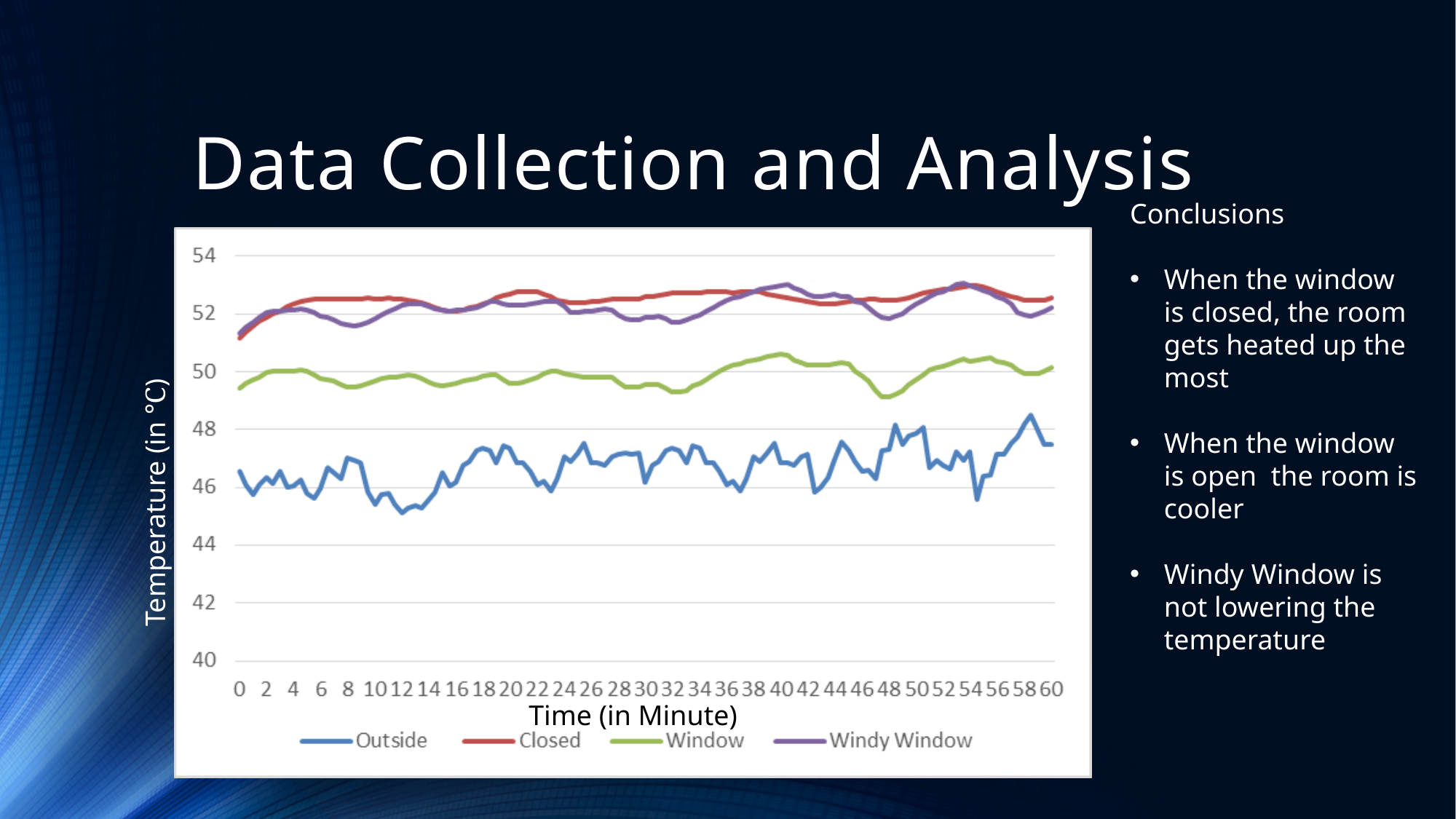
How many series does the chart legend list? 4 What is the title of the vertical axis of the chart? Temperature (in °C) Is the value for the Windy Window series at minute 40 greater or less than 52? greater What kind of chart is shown on the slide? Line chart What are the four series named in the chart legend? Outside, Closed, Window, Windy Window Is the value for the Outside series at minute 12 greater or less than 46? less Is the value for the Closed series at minute 0 greater or less than 50? greater Which series has the lowest temperature values throughout the chart? Outside At minute 30, which series has the larger value, Closed or Outside? Closed At minute 20, which series has the larger value, Window or Outside? Window